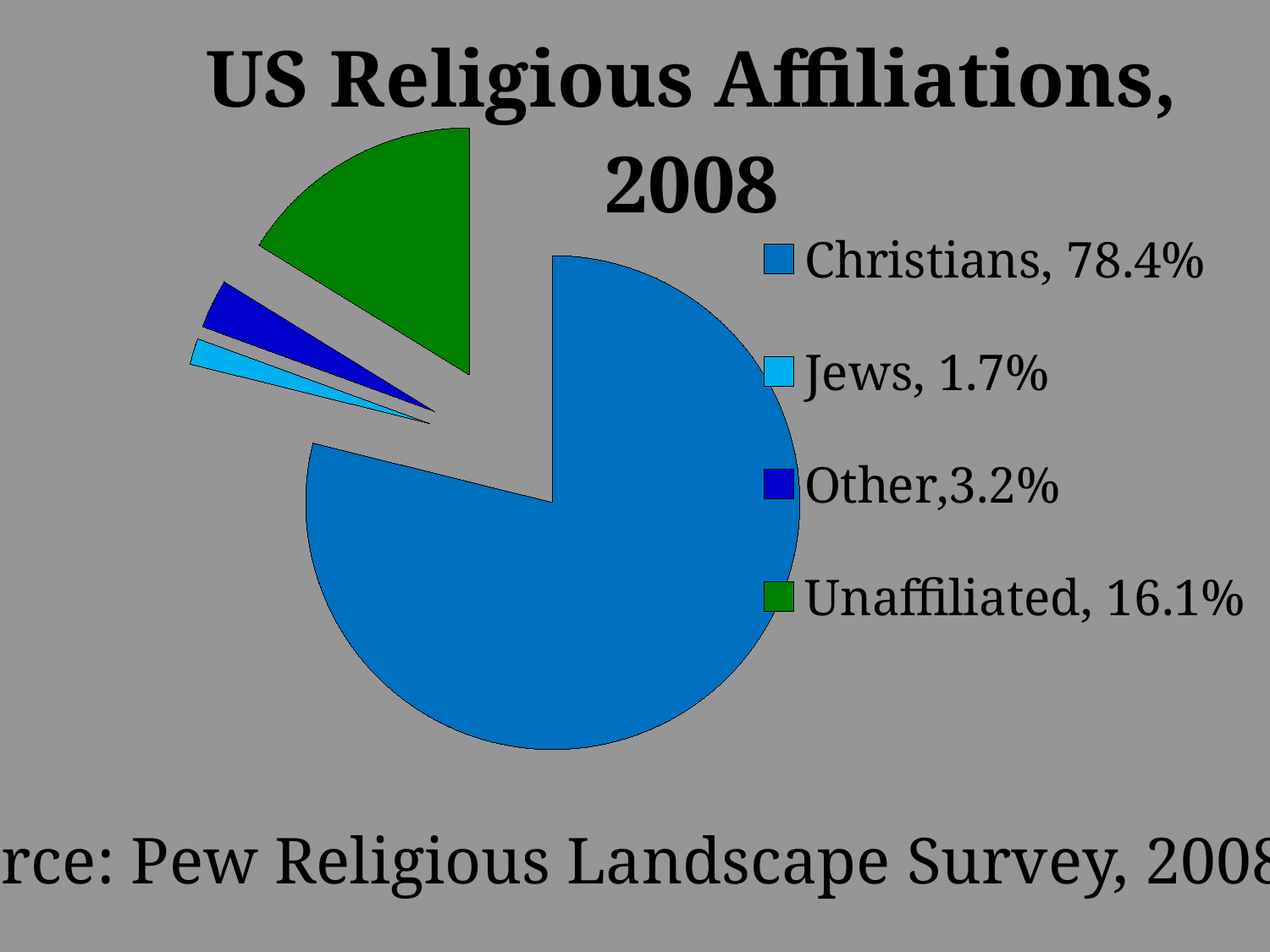
What is the title of the chart? US Religious Affiliations, 2008 What is the difference in percentage points between Unaffiliated and Other? 12.9 What kind of chart is shown on the slide? pie chart What percentage of the pie is Christians? 78.4% What percentage of the pie is Unaffiliated? 16.1% Which category has the smallest share of the pie? Jews Which is larger, the share for Other or the share for Jews? Other What colour is the Unaffiliated slice? green How many categories does the pie chart show? 4 What percentage of the pie is Other? 3.2% Which category has the largest share of the pie? Christians What percentage of the pie is Jews? 1.7%